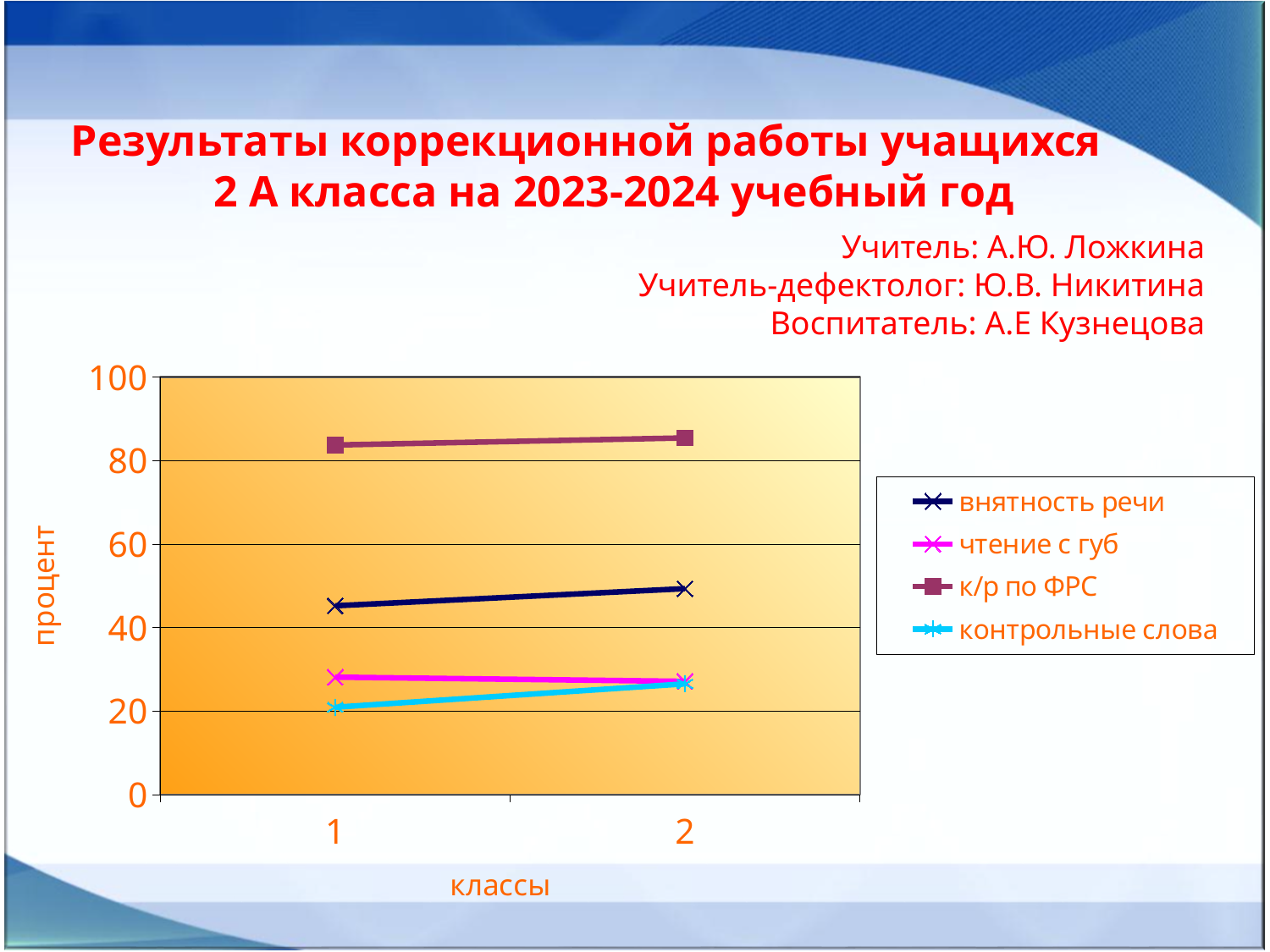
What is the title of the y axis? процент What kind of chart is shown on the slide? line chart How many categories are shown on the x axis? 2 How many series does the legend list? 4 Does the value for контрольные слова rise or fall from class 1 to class 2? rise Which series has the highest value at class 1? к/р по ФРС Does the value for внятность речи rise or fall from class 1 to class 2? rise At class 1, which is larger: внятность речи or чтение с губ? внятность речи Is the value for к/р по ФРС at class 2 greater or less than 80? greater Is the value for контрольные слова at class 1 greater or less than 40? less Is the value for внятность речи at class 2 greater or less than 60? less Which series has the lowest value at class 1? контрольные слова